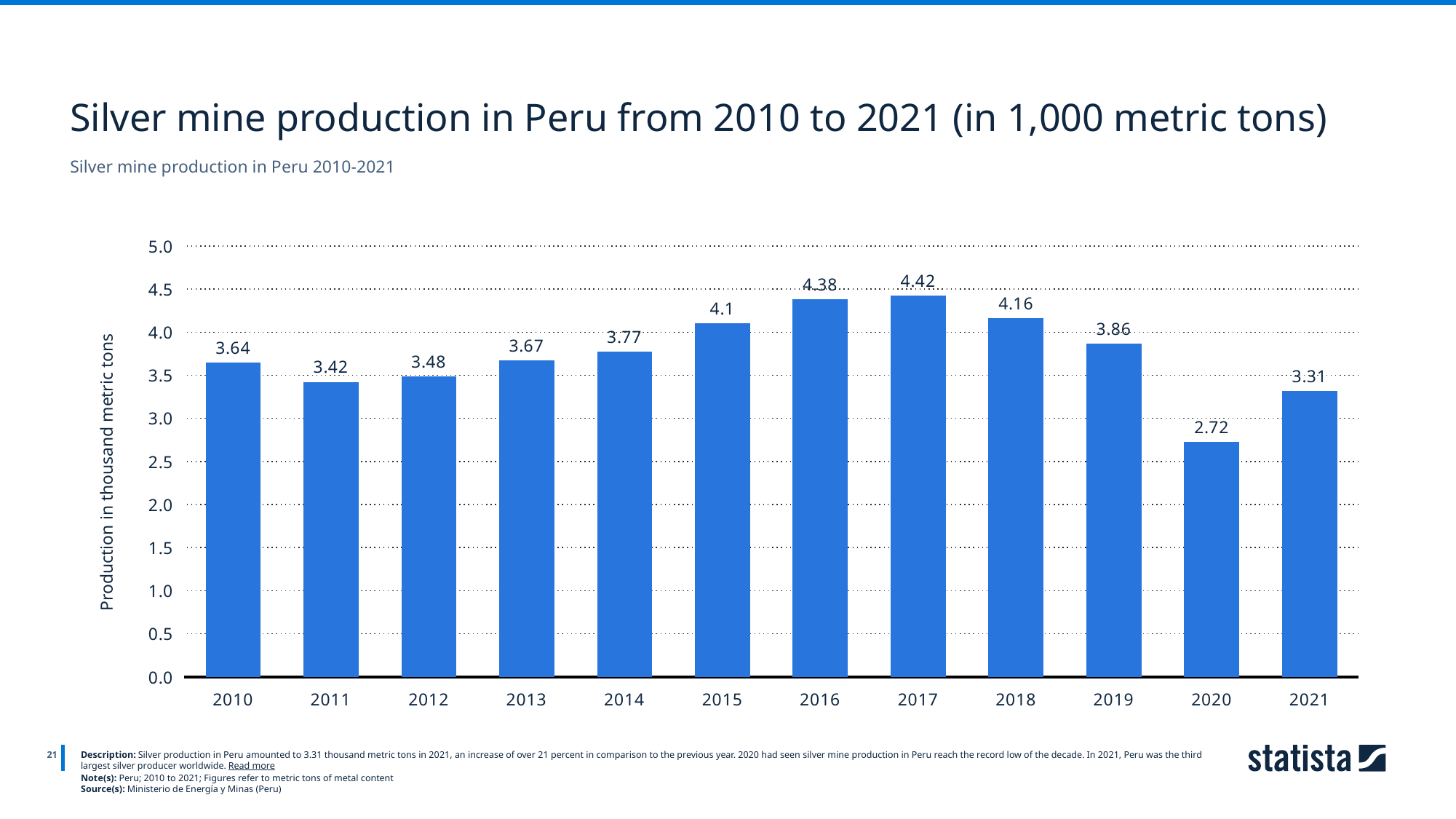
Which year had higher silver mine production, 2015 or 2019? 2015 How many years are shown on the chart? 12 Which year had the highest silver mine production in Peru? 2017 Which year had the lowest silver mine production in Peru? 2020 Did silver mine production in Peru rise or fall from 2017 to 2020? Fall What was the silver mine production in Peru in 2020? 2.72 Is the value for 2016 greater or less than 4.0? greater What is the difference in silver mine production between 2017 and 2020? 1.7 What kind of chart is shown on the slide? Bar chart What was the silver mine production in Peru in 2010? 3.64 What is the label of the y axis? Production in thousand metric tons What was the silver mine production in Peru in 2017? 4.42